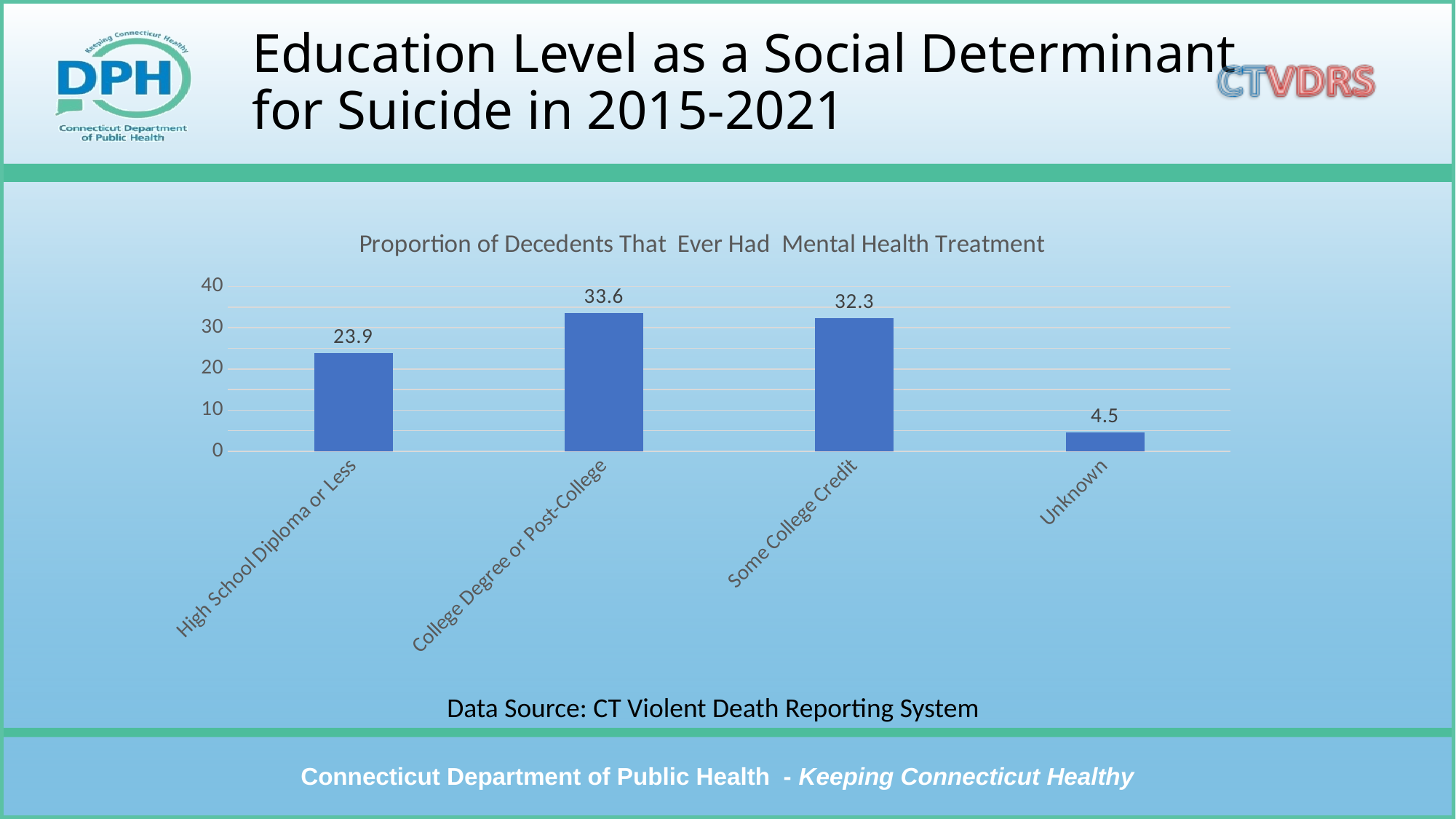
Which category has the lowest value? Unknown Which category has the highest value? College Degree or Post-College Which is larger, the value for Some College Credit or the value for High School Diploma or Less? Some College Credit What is the value for College Degree or Post-College? 33.6 What kind of chart is shown on the slide? bar chart What is the title of the chart? Proportion of Decedents That Ever Had Mental Health Treatment What is the value for Unknown? 4.5 How many categories are shown on the chart? 4 What is the value for High School Diploma or Less? 23.9 Is the value for High School Diploma or Less greater or less than 20? greater What is the value for Some College Credit? 32.3 What is the difference between the values for College Degree or Post-College and High School Diploma or Less? 9.7